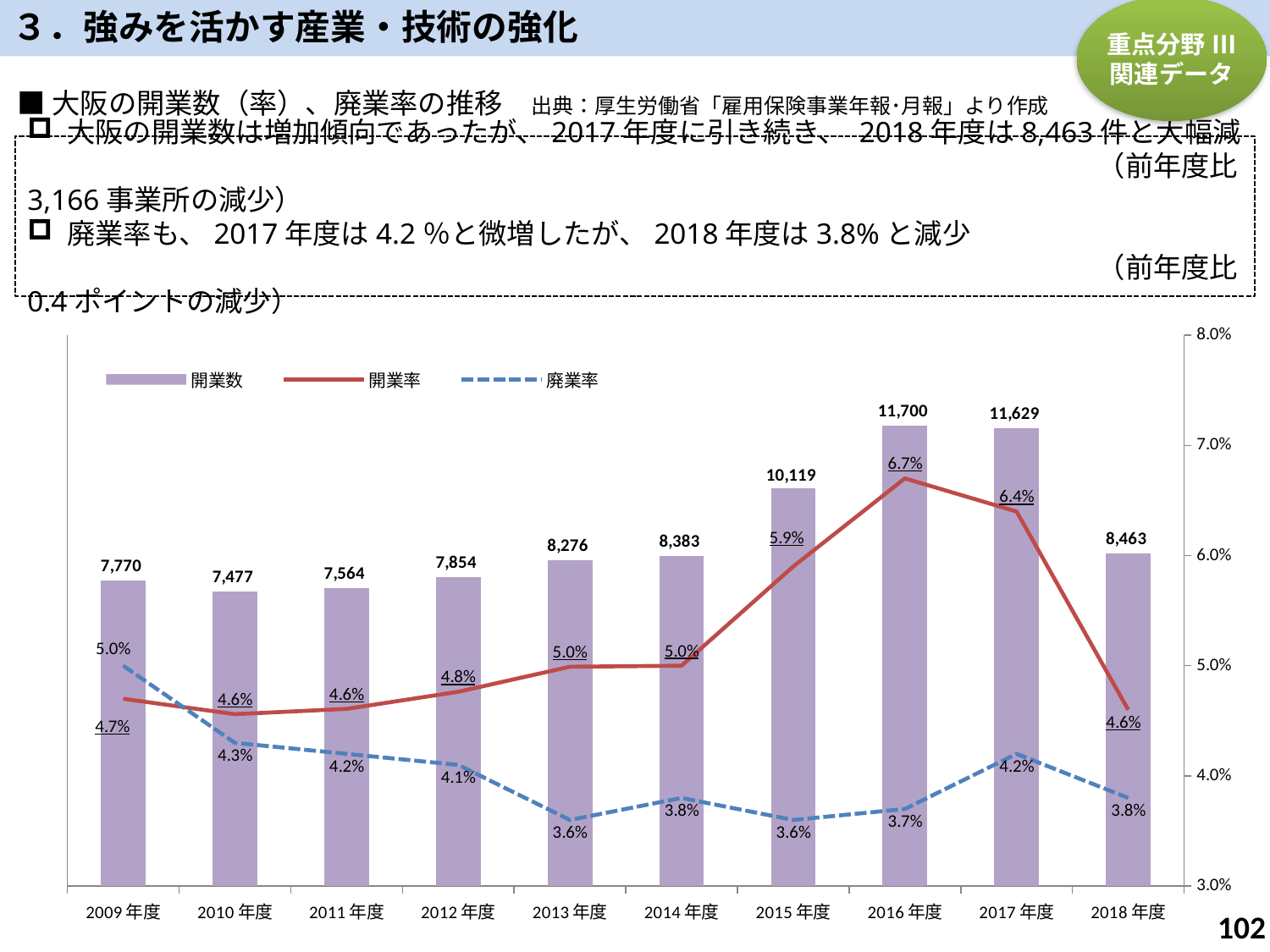
What is the value of 開業数 for 2016年度? 11,700 Which is larger, the 開業率 or the 廃業率 in 2009年度? 廃業率 How many years (categories) are shown on the x axis? 10 What is the difference in 開業数 between 2017年度 and 2018年度? 3,166 Which year has the lowest 開業数? 2010年度 What is the 廃業率 for 2013年度? 3.6% What kind of chart is used to show 開業数? bar chart How many series does the legend list? 3 Does the 開業率 rise or fall from 2017年度 to 2018年度? fall Which year has the highest 開業数? 2016年度 Which series is drawn as a dashed line? 廃業率 What is the 開業率 for 2017年度? 6.4%